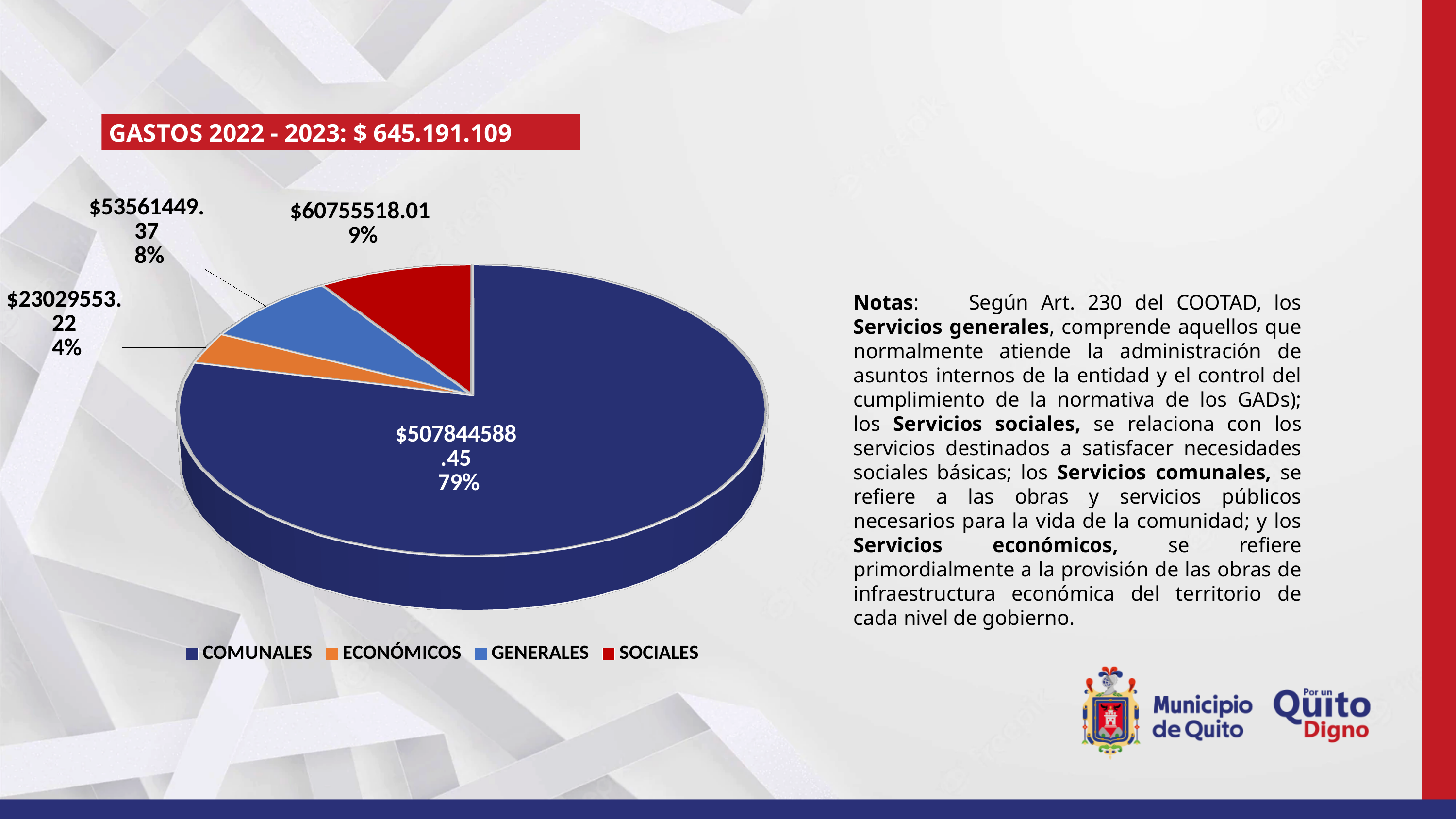
What is the title shown above the chart? GASTOS 2022 - 2023: $ 645.191.109 What is the value shown for COMUNALES? $507844588.45 What percentage share does GENERALES have? 8% What kind of chart is shown on the slide? pie chart How many categories does the legend list? 4 Which category has the smallest slice? ECONÓMICOS Which is larger, the value for SOCIALES or the value for GENERALES? SOCIALES What colour is the SOCIALES slice? red What percentage share does COMUNALES have? 79% What is the value shown for ECONÓMICOS? $23029553.22 Which category has the largest slice? COMUNALES What is the value shown for SOCIALES? $60755518.01